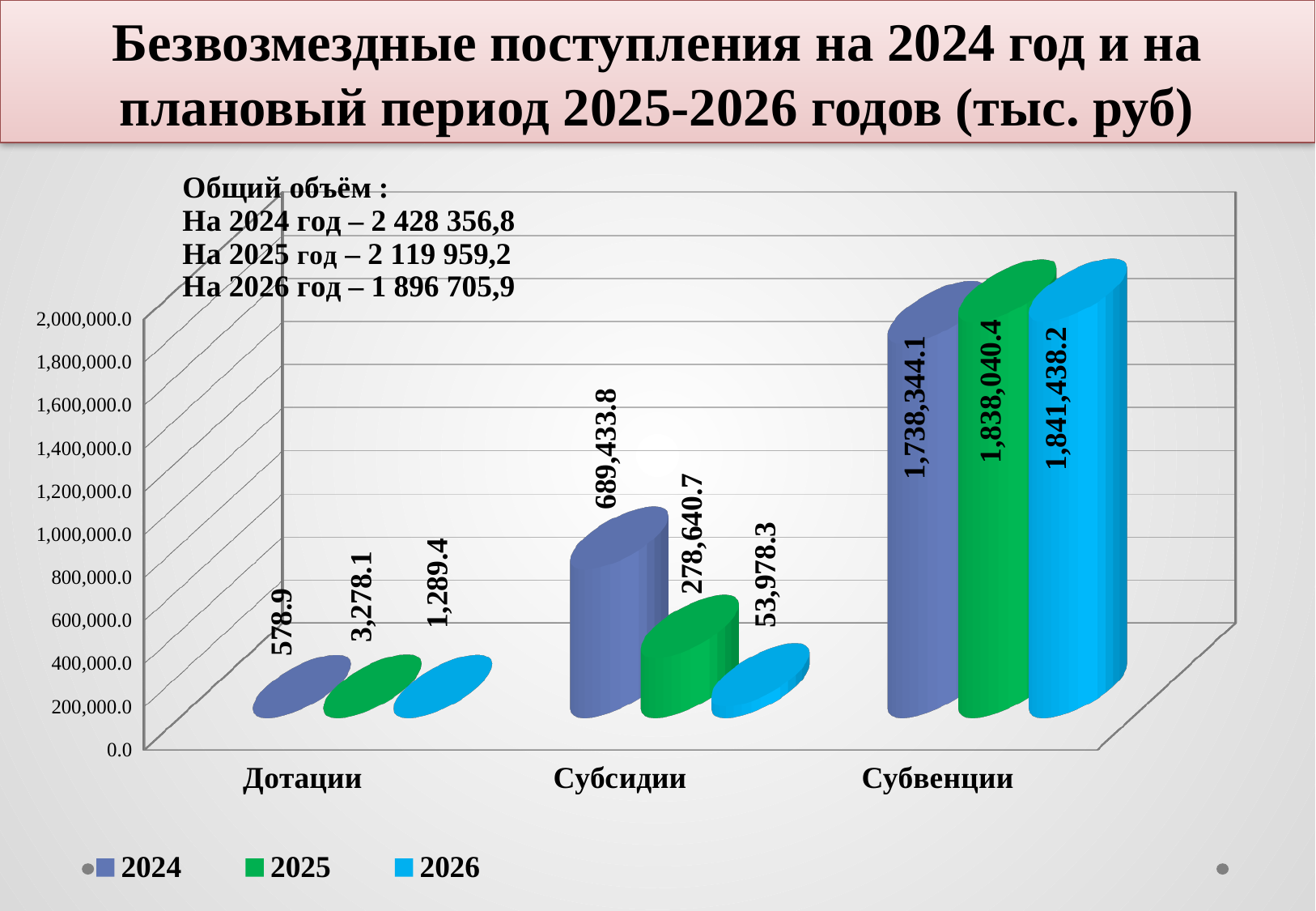
What is the difference between the 2024 and 2025 values for Субсидии? 410,793.1 Which is larger for Субсидии: the 2024 value or the 2025 value? 2024 What is the value for Субсидии in 2026? 53,978.3 What kind of chart is shown on the slide? bar chart What is the value for Субсидии in 2024? 689,433.8 What is the value for Дотации in 2025? 3,278.1 Which category has the highest value for the 2024 series? Субвенции How many categories are shown on the x axis? 3 What is the value for Субвенции in 2026? 1,841,438.2 Which category has the lowest value for the 2026 series? Дотации How many series does the legend list? 3 What is the difference between the 2026 and 2025 values for Субвенции? 3,397.8